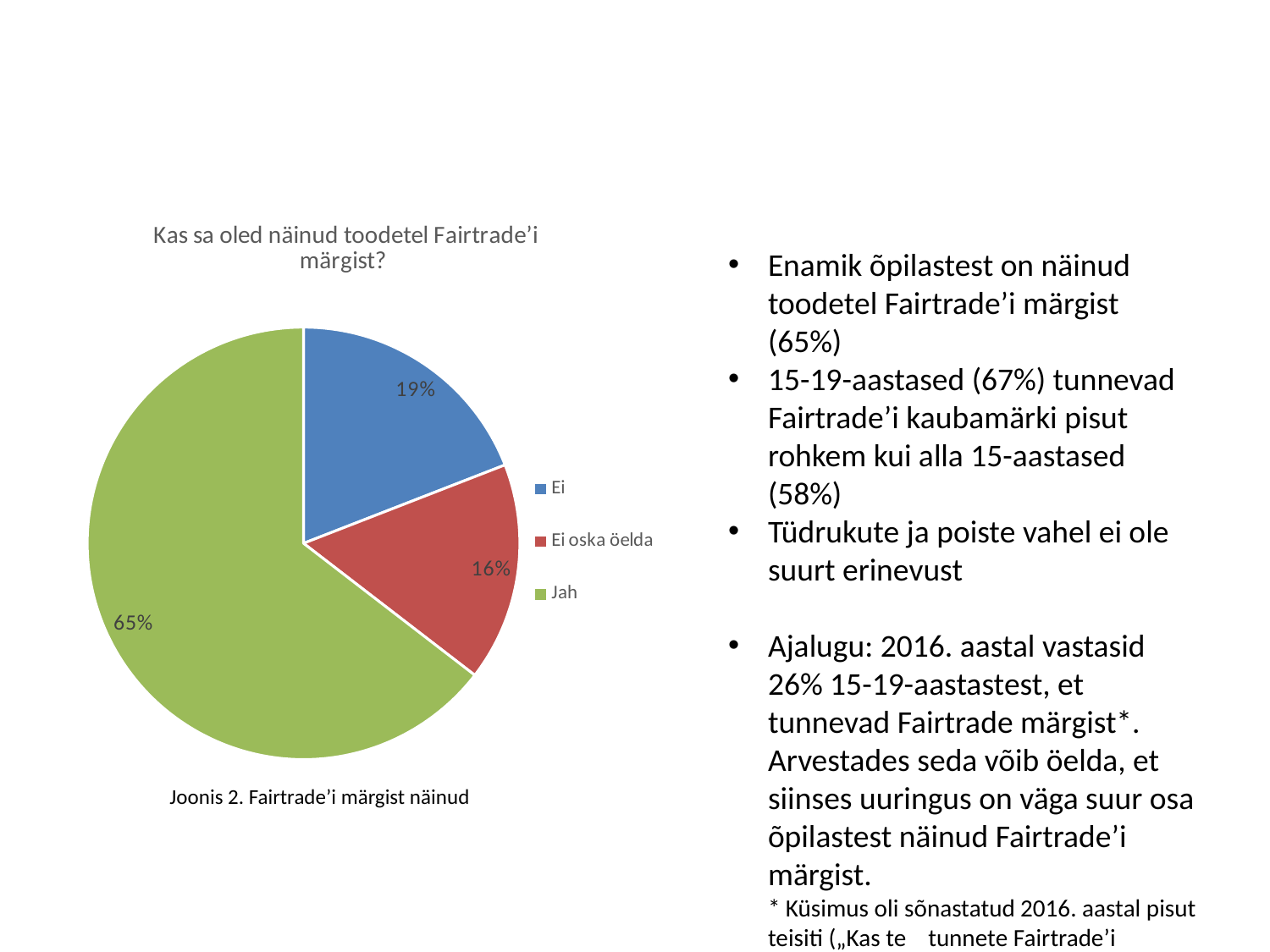
What share of the pie does the "Ei oska öelda" slice represent? 16% What kind of chart is shown on the slide? pie chart What is the title of the pie chart? Kas sa oled näinud toodetel Fairtrade’i märgist? What share of the pie does the "Jah" slice represent? 65% Which category has the smallest slice of the pie? Ei oska öelda What is the combined share of the "Ei" and "Ei oska öelda" slices? 35% Which is larger, the "Ei" slice or the "Ei oska öelda" slice? Ei What is the difference in percentage points between the "Jah" slice and the "Ei" slice? 46 What share of the pie does the "Ei" slice represent? 19% What colour is the "Jah" slice in the pie chart? green Which category has the largest slice of the pie? Jah How many categories does the pie chart have? 3